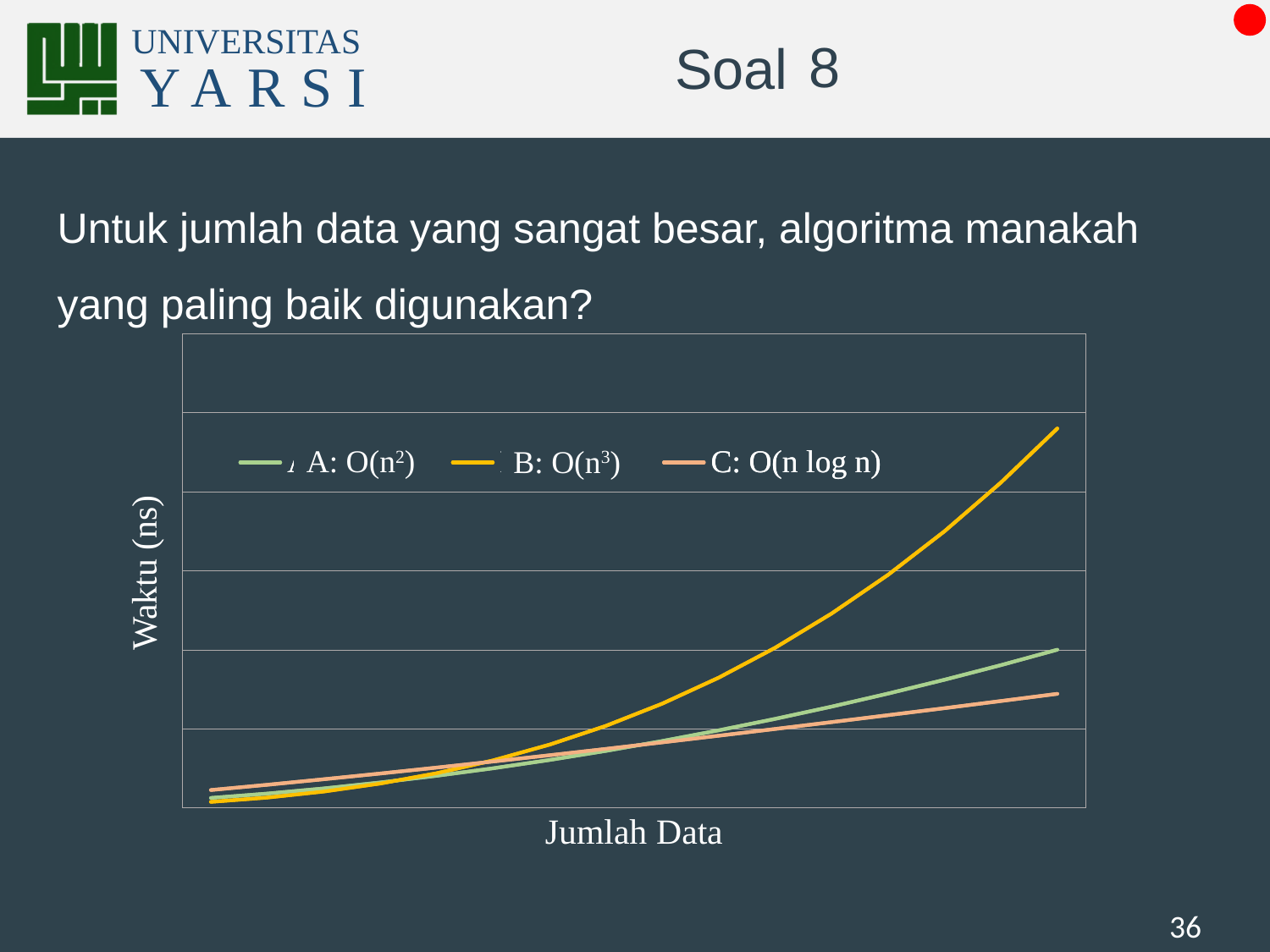
At the right end of the x axis, which is larger, the value for B: O(n³) or the value for A: O(n²)? B: O(n³) What is the label of the chart's vertical axis? Waktu (ns) What kind of chart is shown on the slide? line chart Do the values for C: O(n log n) rise or fall along the x axis? rise Which series has the highest value at the right end of the x axis? B: O(n³) Do the values for B: O(n³) rise or fall as Jumlah Data increases? rise Which series has the lowest value at the right end of the x axis? C: O(n log n) Which series is drawn with the yellow line? B: O(n³) At the right end of the x axis, which is larger, the value for A: O(n²) or the value for C: O(n log n)? A: O(n²) How many series does the chart's legend list? 3